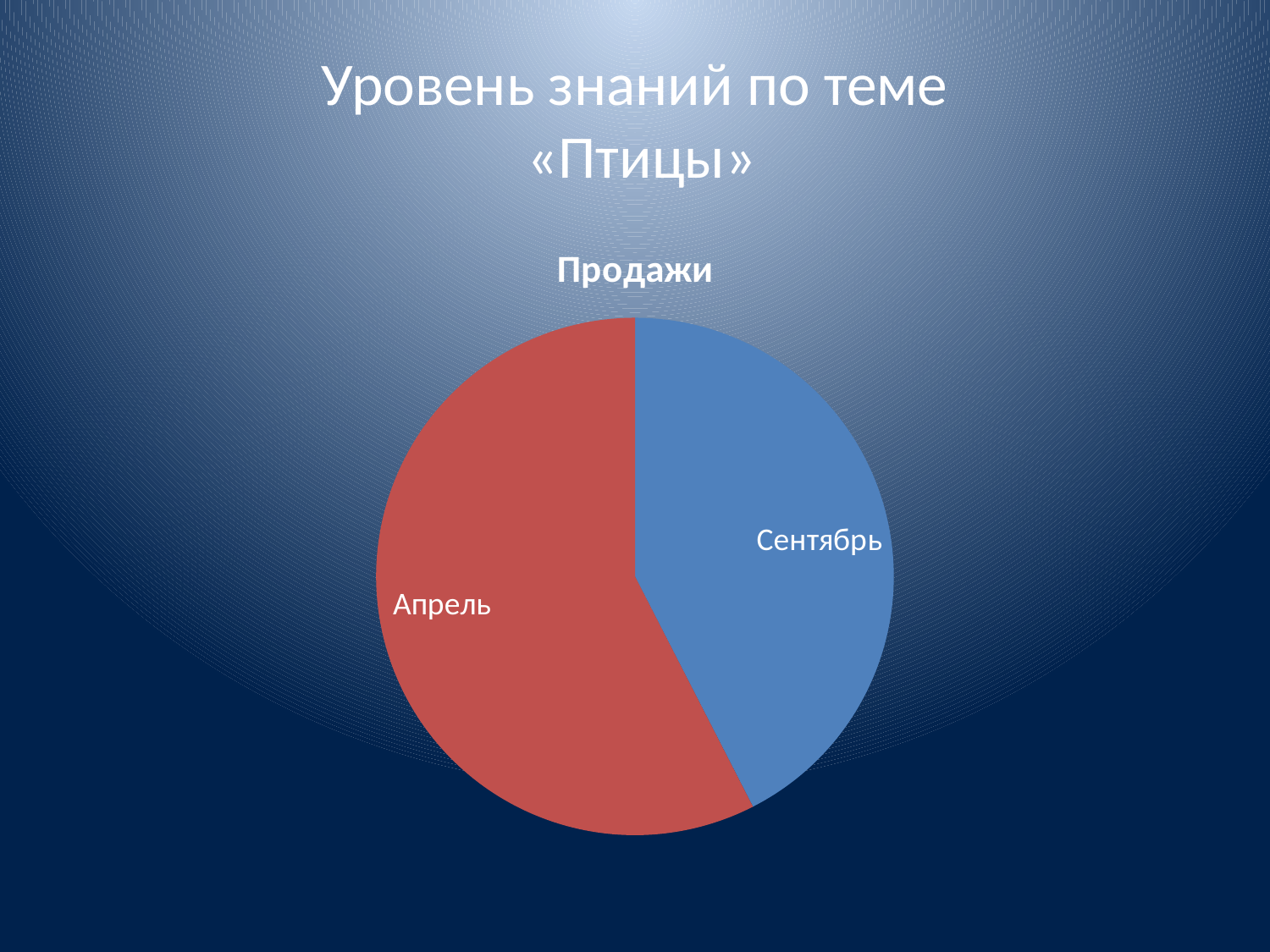
How many slices does the pie chart have? 2 What are the labels of the two slices in the pie chart? Апрель and Сентябрь What kind of chart is shown on the slide? pie chart Which slice of the pie chart is the smallest? Сентябрь Which slice is larger, Апрель or Сентябрь? Апрель What is the title of the chart? Продажи Which slice of the pie chart is the largest? Апрель What colour is the Апрель slice? red